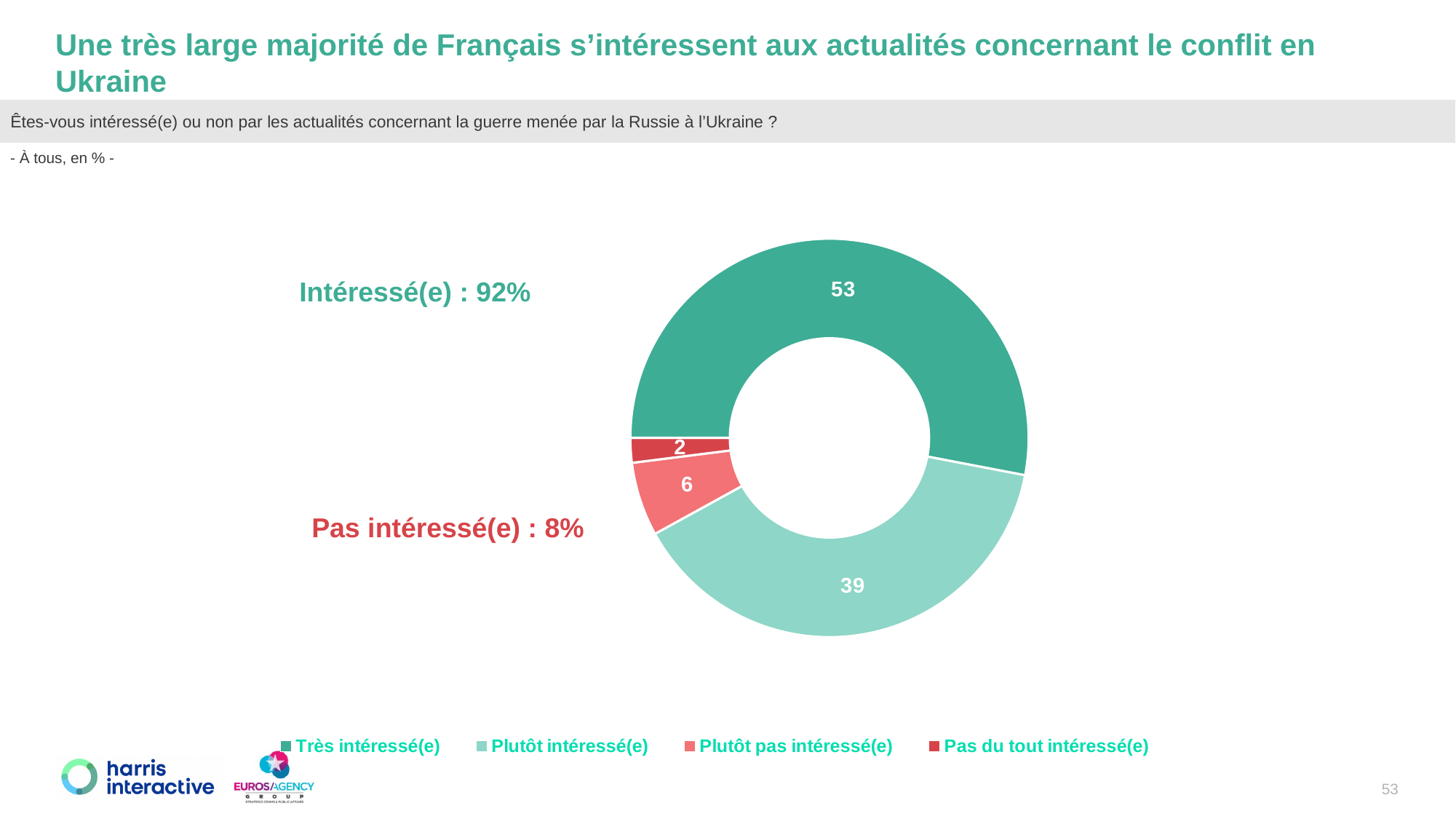
What kind of chart is shown on the slide? Doughnut chart What value is shown for "Plutôt intéressé(e)"? 39 What value is shown for "Très intéressé(e)"? 53 What value is shown for "Pas du tout intéressé(e)"? 2 Which category has the largest share of the chart? Très intéressé(e) Which is larger, the value for "Plutôt pas intéressé(e)" or "Pas du tout intéressé(e)"? Plutôt pas intéressé(e) What combined percentage is shown on the slide for "Intéressé(e)"? 92% What is the difference between the values for "Très intéressé(e)" and "Plutôt intéressé(e)"? 14 What value is shown for "Plutôt pas intéressé(e)"? 6 How many categories does the chart show? 4 Which category has the smallest share of the chart? Pas du tout intéressé(e) What combined percentage is shown on the slide for "Pas intéressé(e)"? 8%